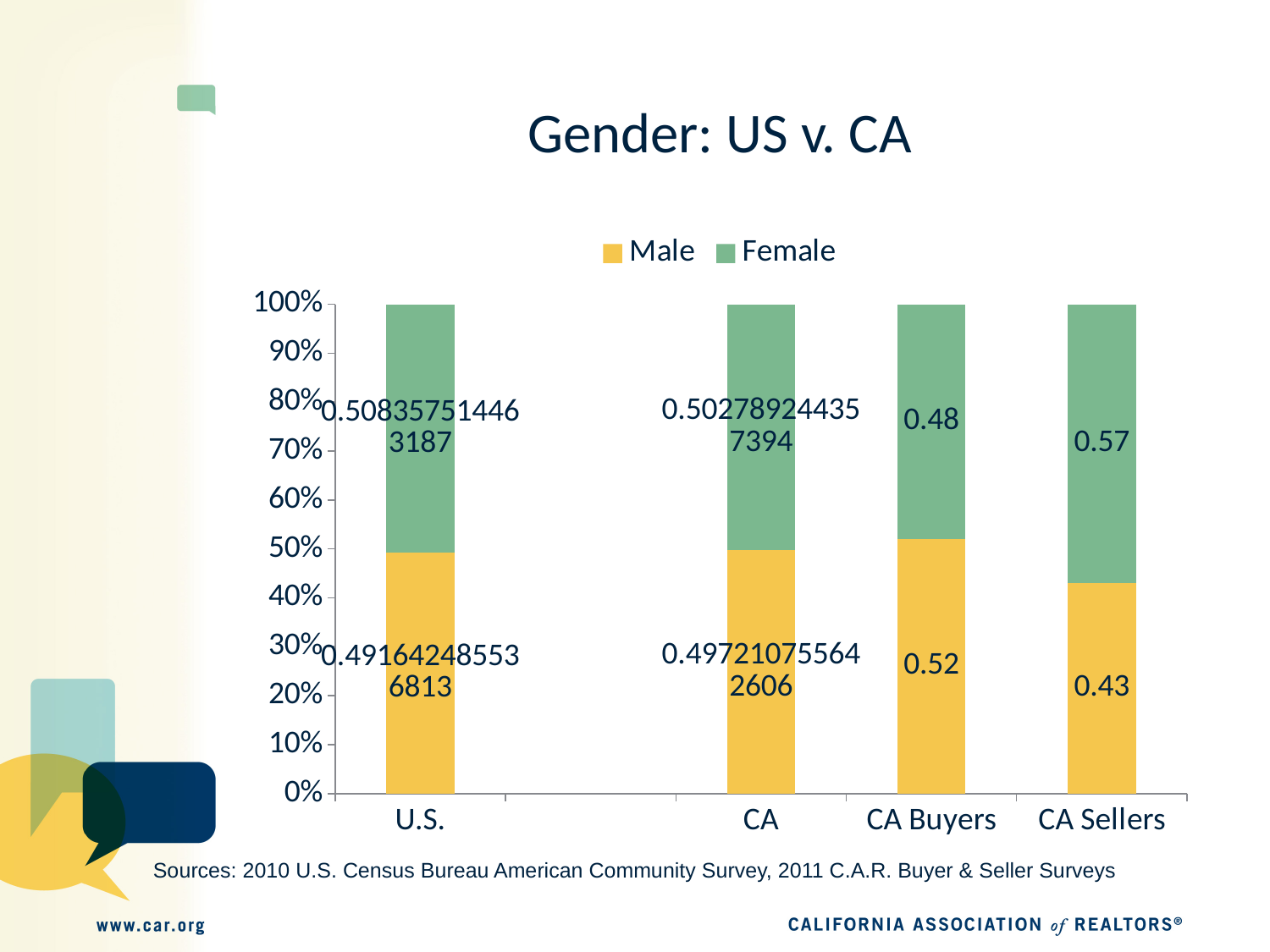
What is the Male value for CA Buyers? 0.52 Is the Male value larger for CA Buyers or for CA Sellers? CA Buyers How many series does the legend list? 2 What is the Male value for CA Sellers? 0.43 What is the Female value for CA Sellers? 0.57 What kind of chart is shown on the slide? stacked bar chart What is the difference between the Female and Male values for CA Sellers? 0.14 What is the Female value for CA Buyers? 0.48 What is the title of the chart? Gender: US v. CA Which category has the lowest Male value? CA Sellers Which category has the highest Female value? CA Sellers Is the Male share for CA Sellers greater or less than 50%? less